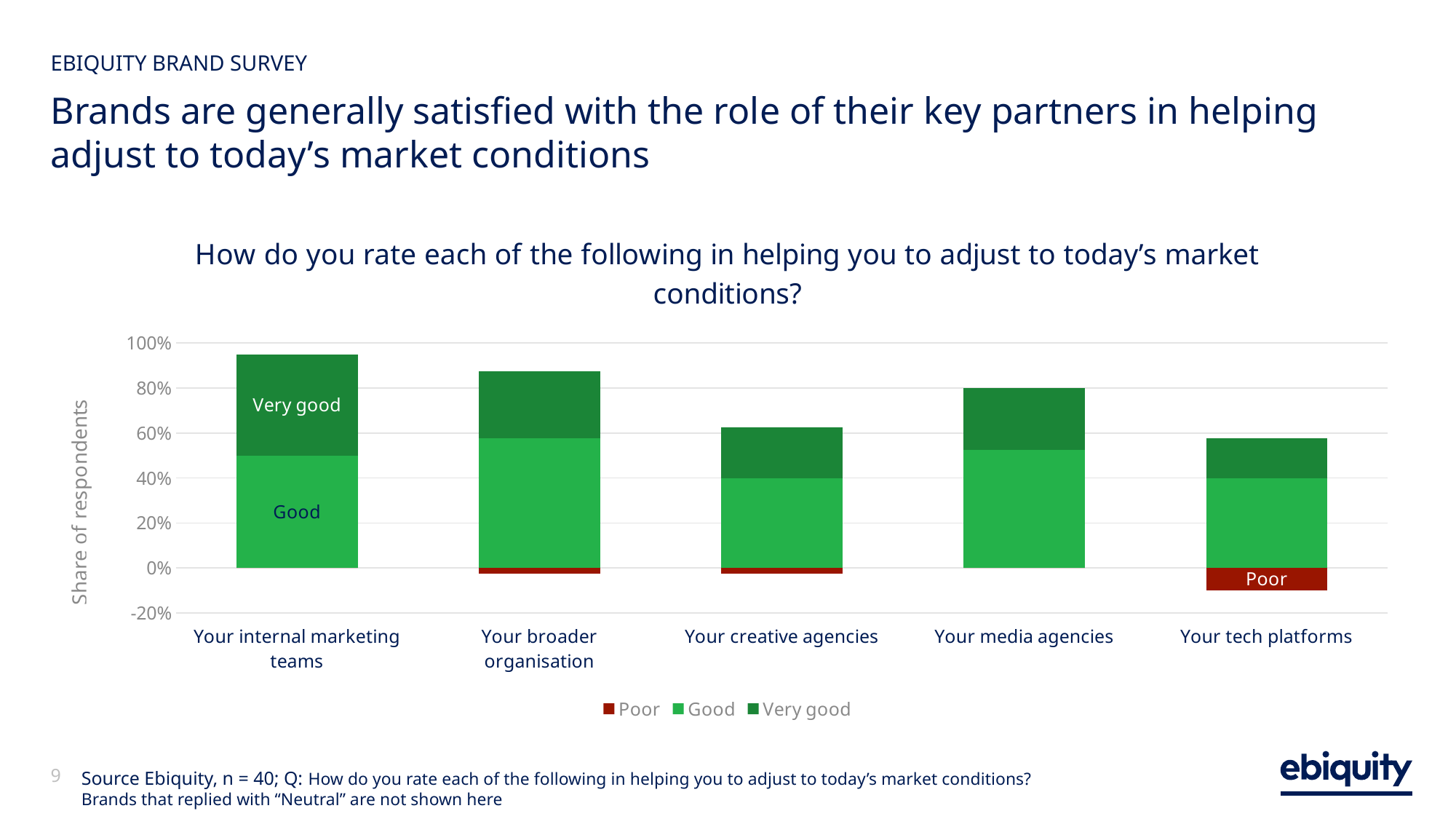
Is the combined Good and Very good share for Your internal marketing teams greater or less than 80%? greater How many series does the chart legend list? 3 Which is larger: the Good share for Your broader organisation or the Good share for Your creative agencies? Your broader organisation What kind of chart is shown on the slide? Stacked bar chart Which category has the largest Poor share? Your tech platforms How many categories are shown on the x axis of the chart? 5 What is the title of the chart's vertical axis? Share of respondents Which category has the shortest stacked bar above 0% (the smallest combined Good and Very good share)? Your tech platforms Is the combined Good and Very good share for Your tech platforms greater or less than 80%? less Is the combined Good and Very good share for Your broader organisation greater or less than 80%? greater Which is larger: the Very good share for Your internal marketing teams or the Very good share for Your creative agencies? Your internal marketing teams Which category has the tallest stacked bar above 0% (the largest combined Good and Very good share)? Your internal marketing teams